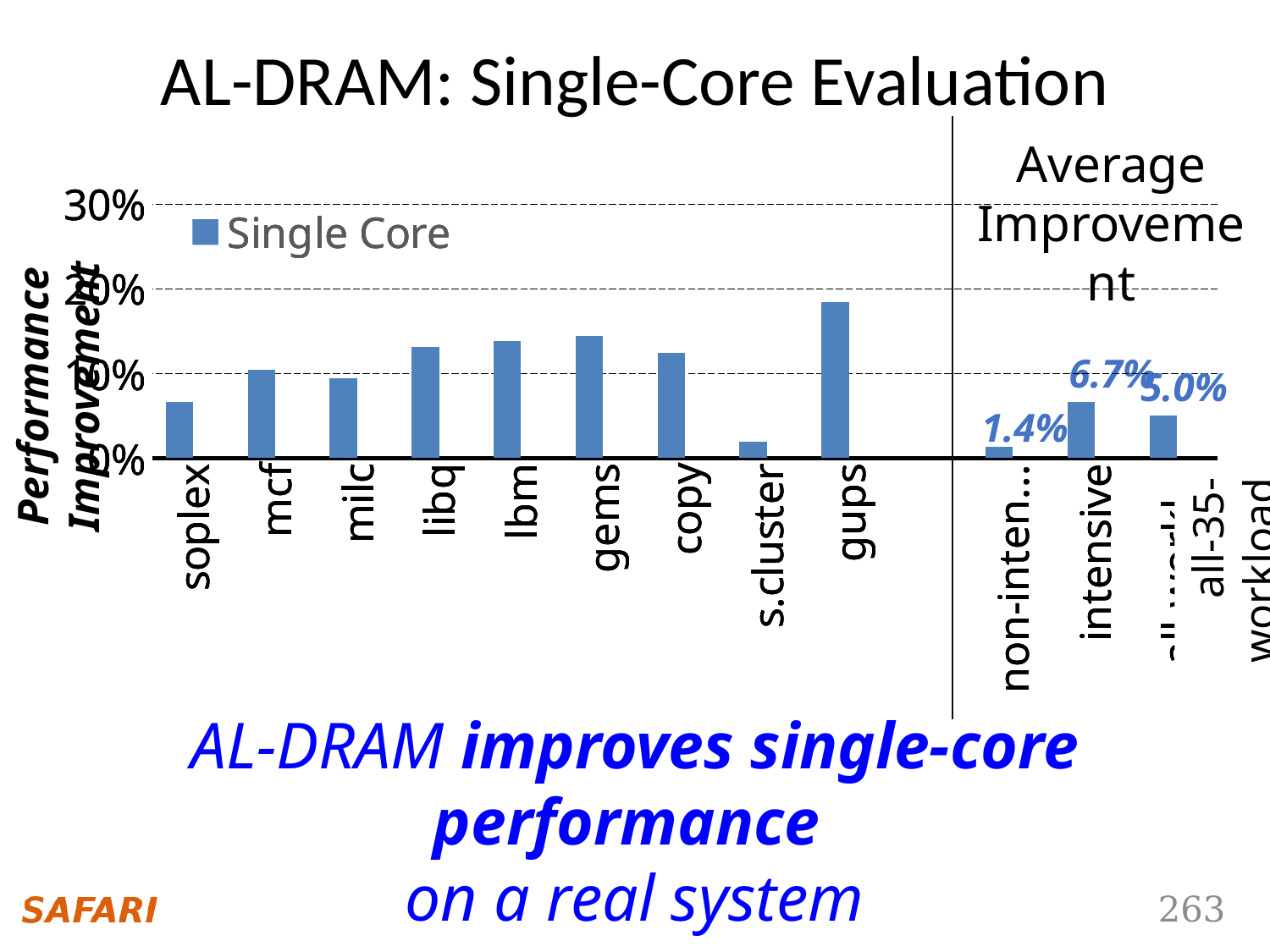
What is the average performance improvement shown for the all-35-workload category? 5.0% Is the performance improvement for gups greater or less than 20%? less What is the average performance improvement shown for the non-intensive workloads? 1.4% What is the difference between the average improvement for intensive workloads and for non-intensive workloads? 5.3% What kind of chart is shown on the slide? bar chart How many series does the legend list? 1 Which has a larger performance improvement, gups or lbm? gups Among the nine individual benchmarks to the left of the divider line, which has the lowest performance improvement? s.cluster What is the average performance improvement shown for the intensive workloads? 6.7% Is the performance improvement for libq greater or less than 10%? greater Which has a larger performance improvement, soplex or mcf? mcf Which workload has the highest single-core performance improvement? gups